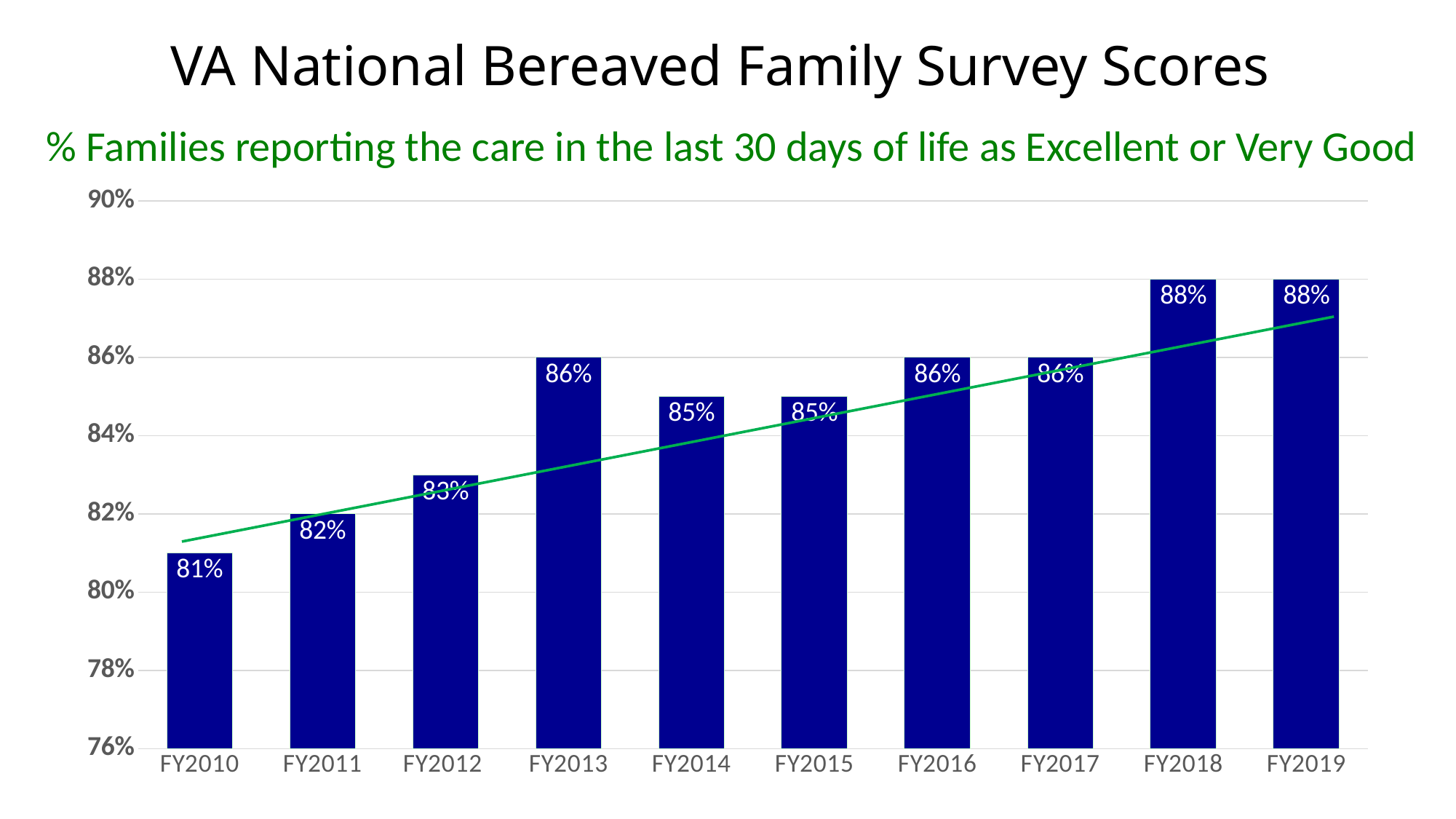
What is the value for FY2013? 86% What is the value for FY2010? 81% What is the difference between the values for FY2019 and FY2010? 7% What kind of chart is this? bar chart How many fiscal years are shown on the x axis? 10 What is the value for FY2019? 88% Which is larger, the value for FY2012 or the value for FY2015? FY2015 What is the title of the chart? VA National Bereaved Family Survey Scores Do the values generally rise or fall from FY2010 to FY2019? rise Is the value for FY2016 greater or less than 84%? greater Which fiscal year has the lowest value? FY2010 What is the difference between the values for FY2013 and FY2014? 1%